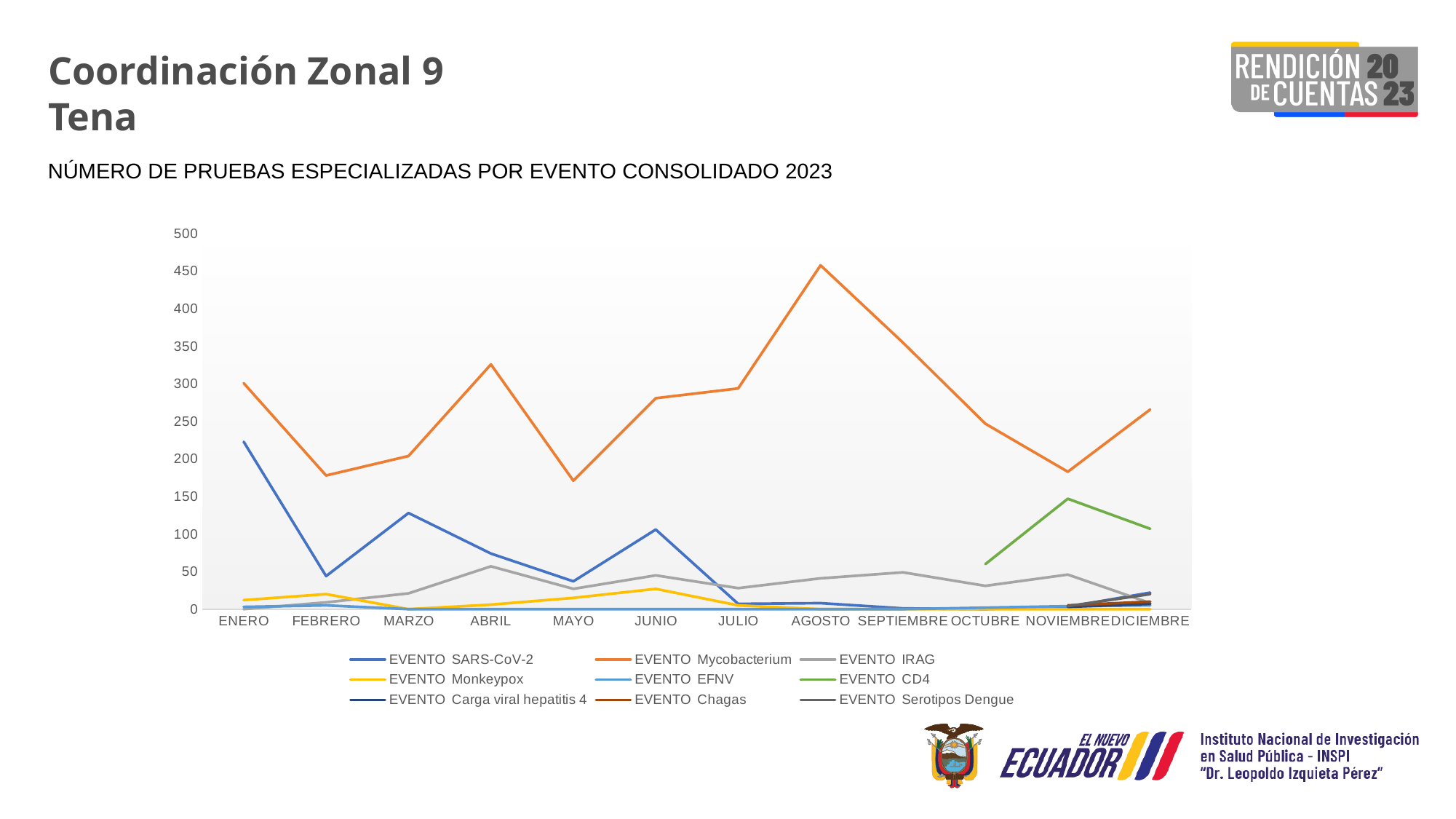
What is the title of the chart? NÚMERO DE PRUEBAS ESPECIALIZADAS POR EVENTO CONSOLIDADO 2023 In which month does the EVENTO Mycobacterium series reach its highest value? AGOSTO Is the value for EVENTO CD4 in NOVIEMBRE greater or less than 100? greater Is the value for EVENTO SARS-CoV-2 in FEBRERO greater or less than 100? less Is the value for EVENTO Mycobacterium in MAYO greater or less than 200? less How many series does the legend list? 9 In ENERO, which series has the larger value, EVENTO Mycobacterium or EVENTO SARS-CoV-2? EVENTO Mycobacterium Does the EVENTO Mycobacterium series rise or fall from AGOSTO to NOVIEMBRE? fall How many months are shown along the x axis? 12 In which month does the EVENTO SARS-CoV-2 series reach its highest value? ENERO What kind of chart is shown on the slide? line chart